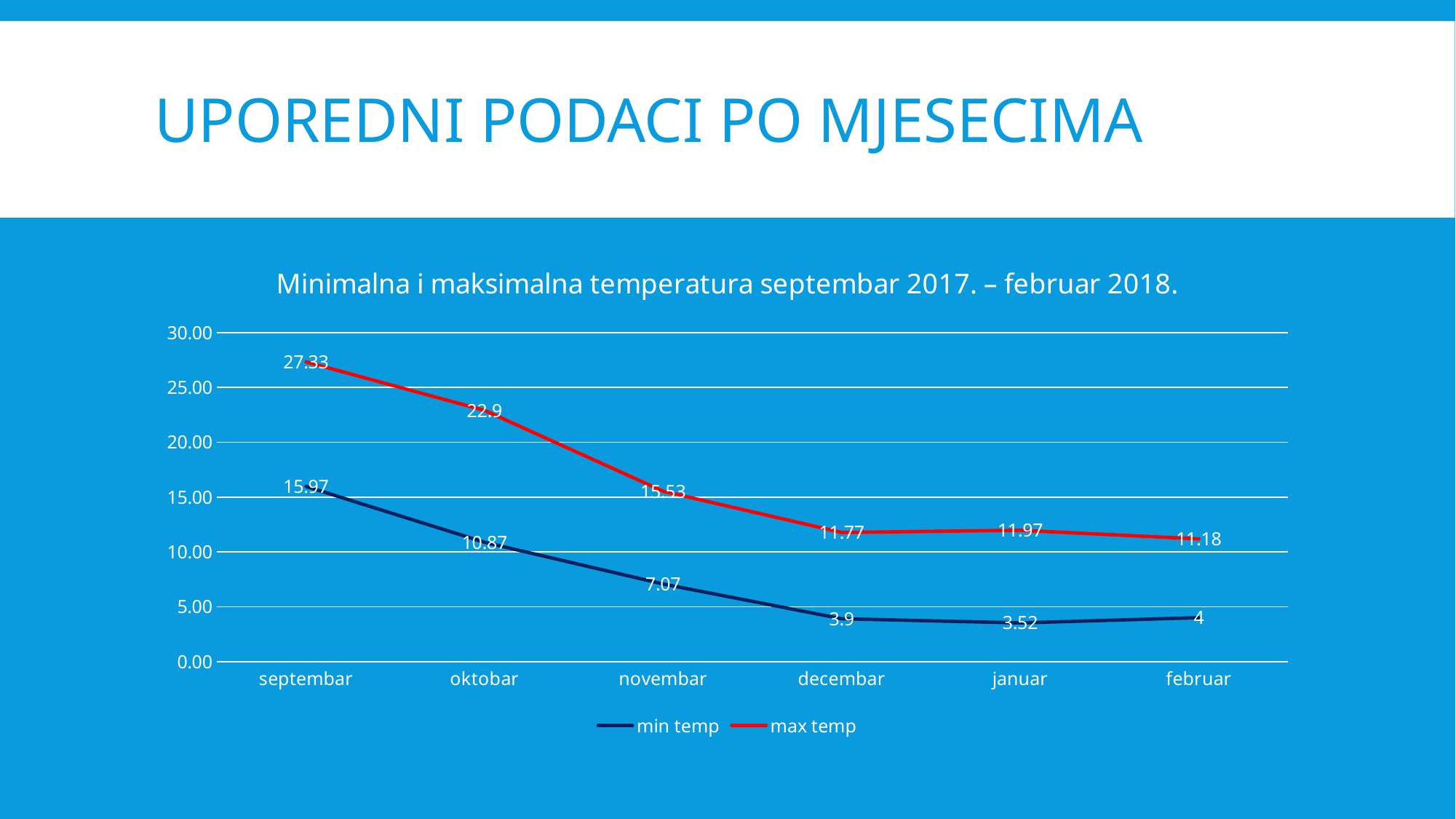
Does the max temp series rise or fall from septembar to decembar? fall Which month has the lowest min temp value? januar How many months are shown on the x axis? 6 What is the min temp value for novembar? 7.07 What is the difference between the max temp and min temp values for decembar? 7.87 How many series does the legend list? 2 Which is larger, the max temp value for januar or the max temp value for februar? januar Which month has the highest max temp value? septembar What is the max temp value for februar? 11.18 Is the min temp value for oktobar greater or less than 10.00? greater What kind of chart is shown on the slide? line chart What is the max temp value for septembar? 27.33